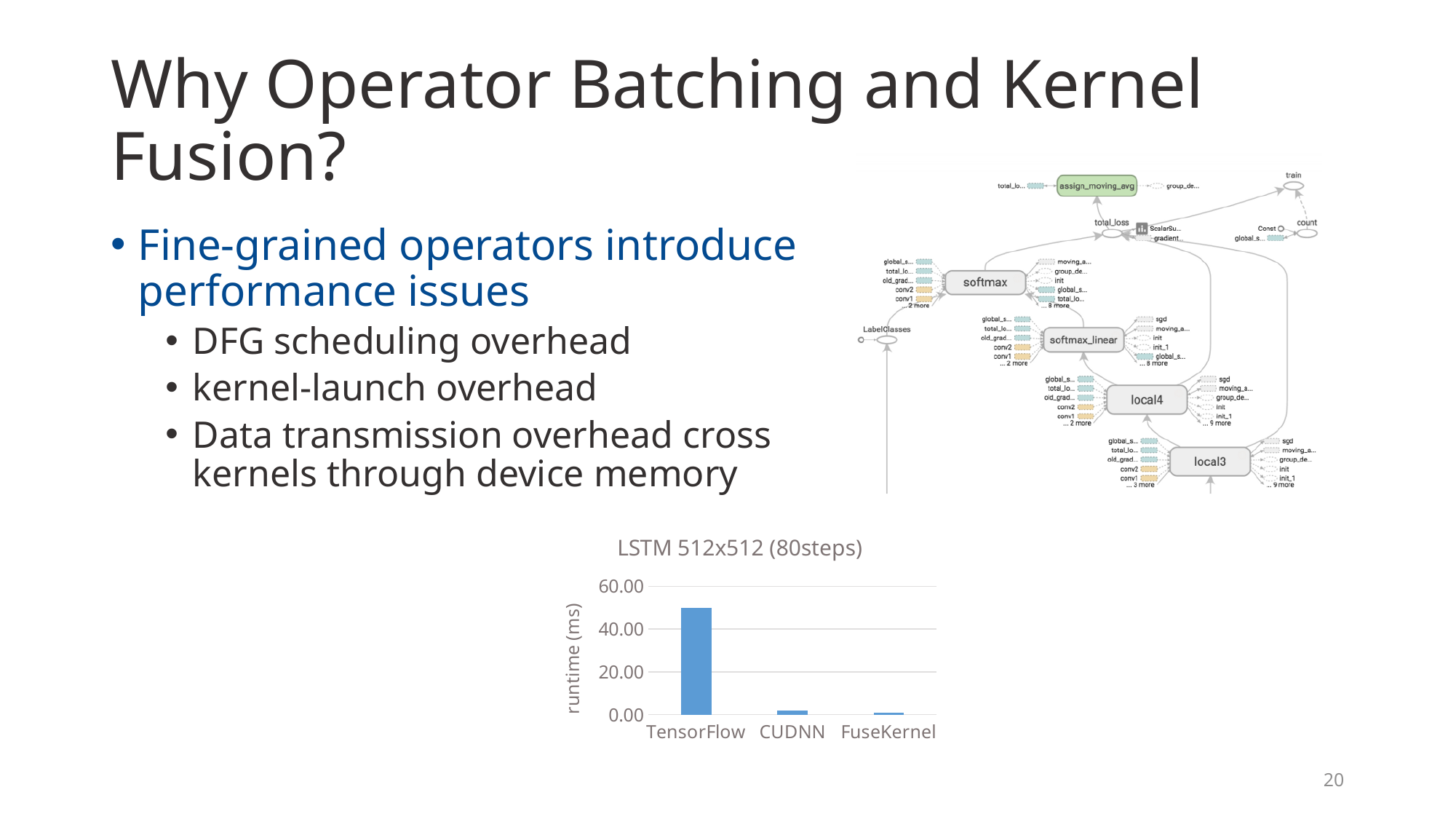
Do the runtime values rise or fall from left to right across the categories? fall Which has a larger runtime, TensorFlow or CUDNN? TensorFlow Is the runtime for TensorFlow greater or less than 40? greater Is the runtime for FuseKernel greater or less than 20? less Which category has the lowest runtime in the chart? FuseKernel What is the label of the vertical axis of the chart? runtime (ms) Is the runtime for CUDNN greater or less than 20? less How many categories are plotted in the chart? 3 What is the title of the chart? LSTM 512x512 (80steps) What kind of chart is shown on the slide? bar chart Which category has the highest runtime in the chart? TensorFlow